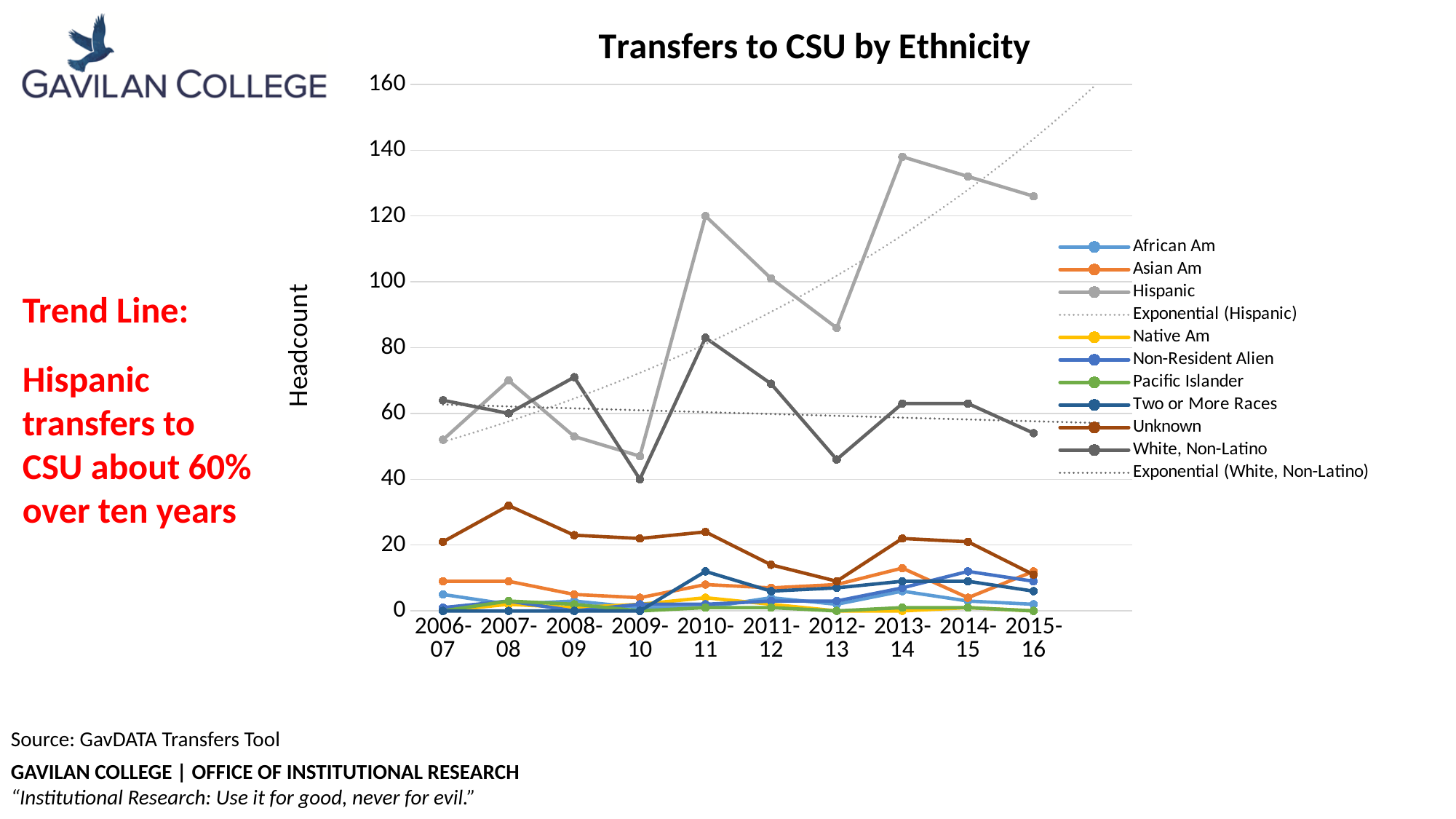
Does the Hispanic series overall rise or fall from 2006-07 to 2015-16? Rise Is the Hispanic value for 2013-14 greater or less than 120? greater How many entries does the chart's legend list? 11 How many academic years are shown along the x axis? 10 In which year does the White, Non-Latino series reach its highest value? 2010-11 What is the label on the vertical axis of the chart? Headcount Is the Unknown value for 2007-08 greater or less than 20? greater In which year does the Hispanic series reach its highest value? 2013-14 In 2006-07, which series has the larger value: Hispanic or White, Non-Latino? White, Non-Latino Is the Hispanic value for 2012-13 greater or less than 100? less What is the title of the chart? Transfers to CSU by Ethnicity What kind of chart is shown on the slide? Line chart